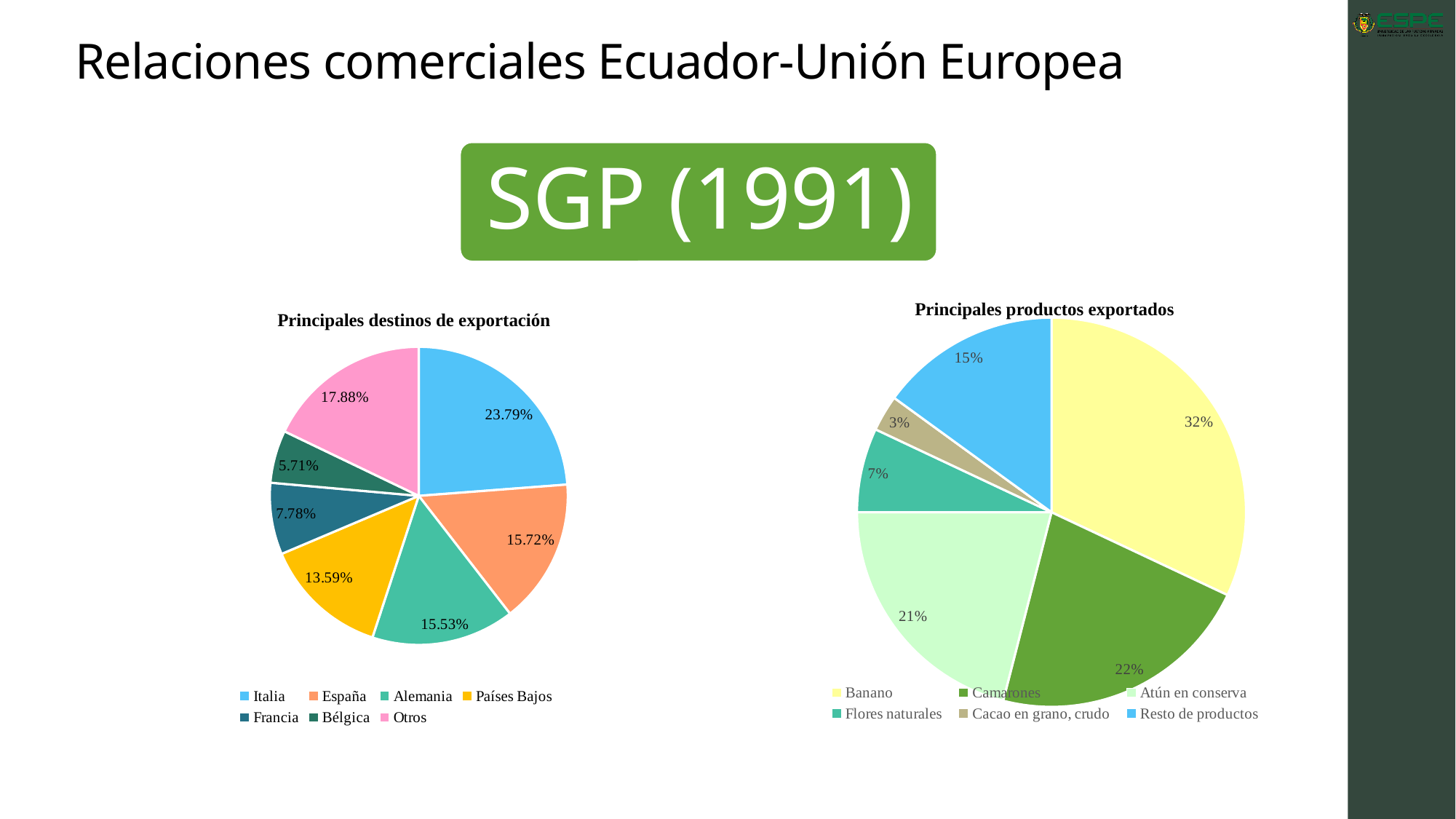
In the 'Principales destinos de exportación' chart, what share does Países Bajos have? 13.59% In the 'Principales productos exportados' chart, which is larger, Flores naturales or Resto de productos? Resto de productos In the 'Principales destinos de exportación' chart, which destination has the smallest share? Bélgica In the 'Principales destinos de exportación' chart, what share does Italia have? 23.79% In the 'Principales productos exportados' chart, what share does Banano have? 32% In the 'Principales productos exportados' chart, what share does Cacao en grano, crudo have? 3% In the 'Principales destinos de exportación' chart, how many slices does the pie have? 7 What type of chart is 'Principales productos exportados'? Pie chart In the 'Principales productos exportados' chart, which product has the largest share? Banano In the 'Principales productos exportados' chart, what is the difference between the shares of Banano and Camarones? 10% In the 'Principales destinos de exportación' chart, which destination has the largest share? Italia In the 'Principales destinos de exportación' chart, what is the difference between the shares of Italia and Otros? 5.91%